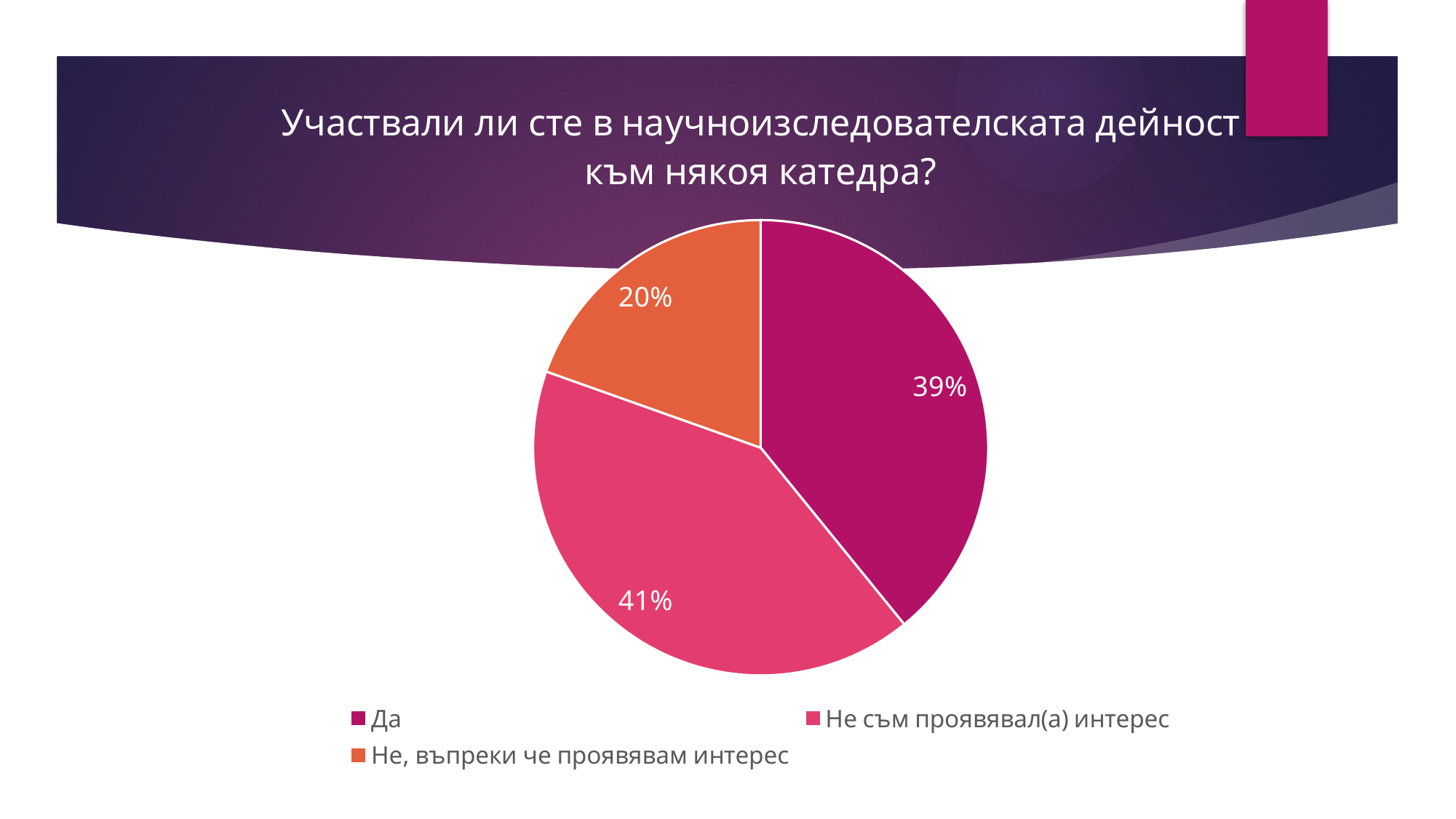
Which category has the largest slice of the pie? Не съм проявявал(а) интерес What colour is the slice for "Не, въпреки че проявявам интерес"? Orange Which is larger: the "Да" slice or the "Не, въпреки че проявявам интерес" slice? Да How many slices does the pie chart have? 3 What is the title of the chart? Участвали ли сте в научноизследователската дейност към някоя катедра? What share of the pie does the slice "Не, въпреки че проявявам интерес" represent? 20% Which category has the smallest slice of the pie? Не, въпреки че проявявам интерес What kind of chart is shown on the slide? Pie chart What share of the pie does the slice "Да" represent? 39% What is the difference in percentage points between the "Не съм проявявал(а) интерес" slice and the "Да" slice? 2 percentage points What is the difference in percentage points between the "Да" slice and the "Не, въпреки че проявявам интерес" slice? 19 percentage points What share of the pie does the slice "Не съм проявявал(а) интерес" represent? 41%